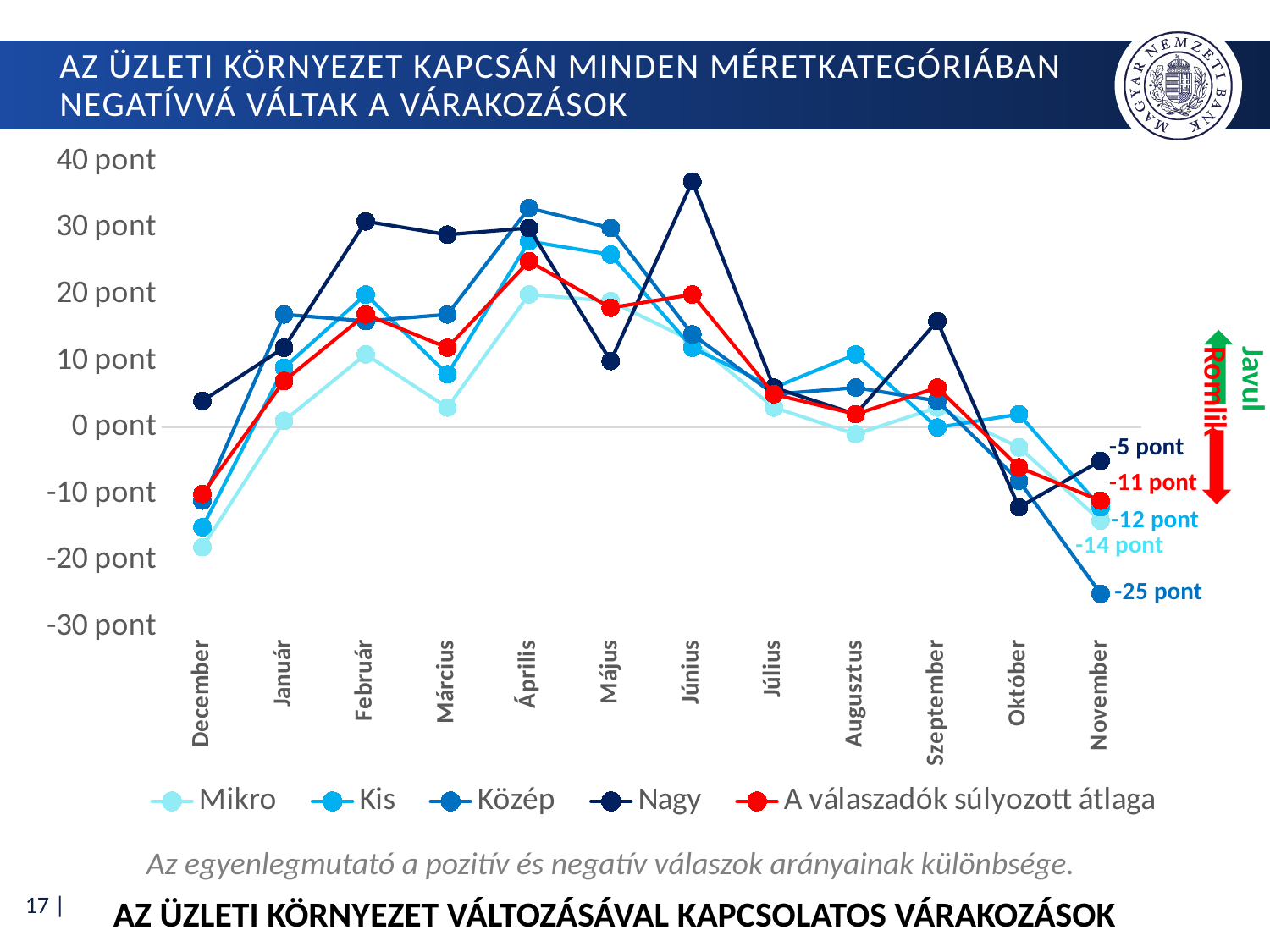
Which colour is used for the 'A válaszadók súlyozott átlaga' series? red What is the value for Közép in November? -25 pont Which series has the highest value in November? Nagy Which series has the lowest value in November? Közép How many months are shown along the x axis? 12 What type of chart is shown on the slide? line chart What is the difference between the Nagy and Közép values in November? 20 pont Is the value for Nagy in Június greater or less than 30 pont? greater What is the value for Nagy in November? -5 pont In November, which is larger: the value for Kis or the value for Mikro? Kis What is the value of 'A válaszadók súlyozott átlaga' in November? -11 pont How many series does the legend list? 5